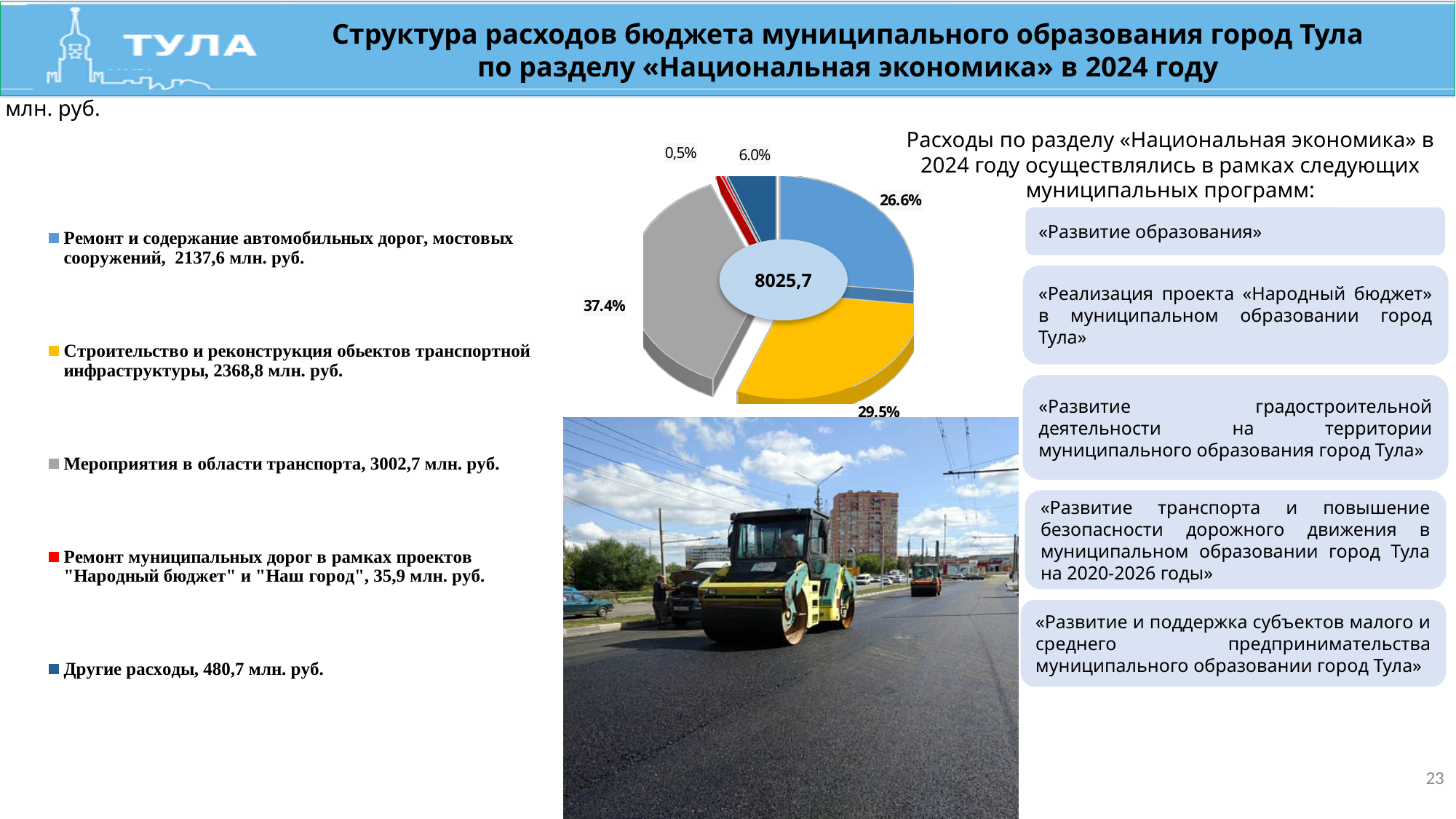
Which category has the smallest share of the pie? Ремонт муниципальных дорог в рамках проектов "Народный бюджет" и "Наш город" What share of the pie does "Другие расходы" represent? 6.0% What share of the pie does "Строительство и реконструкция объектов транспортной инфраструктуры" represent? 29.5% Which category has the largest share of the pie? Мероприятия в области транспорта What share of the pie does "Ремонт и содержание автомобильных дорог, мостовых сооружений" represent? 26.6% How many slices does the pie chart have? 5 What is the value shown in the legend for "Мероприятия в области транспорта"? 3002,7 млн. руб. What is the difference in млн. руб. between "Мероприятия в области транспорта" and "Строительство и реконструкция объектов транспортной инфраструктуры"? 633,9 млн. руб. What total value is printed in the centre of the pie chart? 8025,7 What type of chart is shown on the slide? pie chart What is the value shown in the legend for "Ремонт муниципальных дорог в рамках проектов "Народный бюджет" и "Наш город""? 35,9 млн. руб.